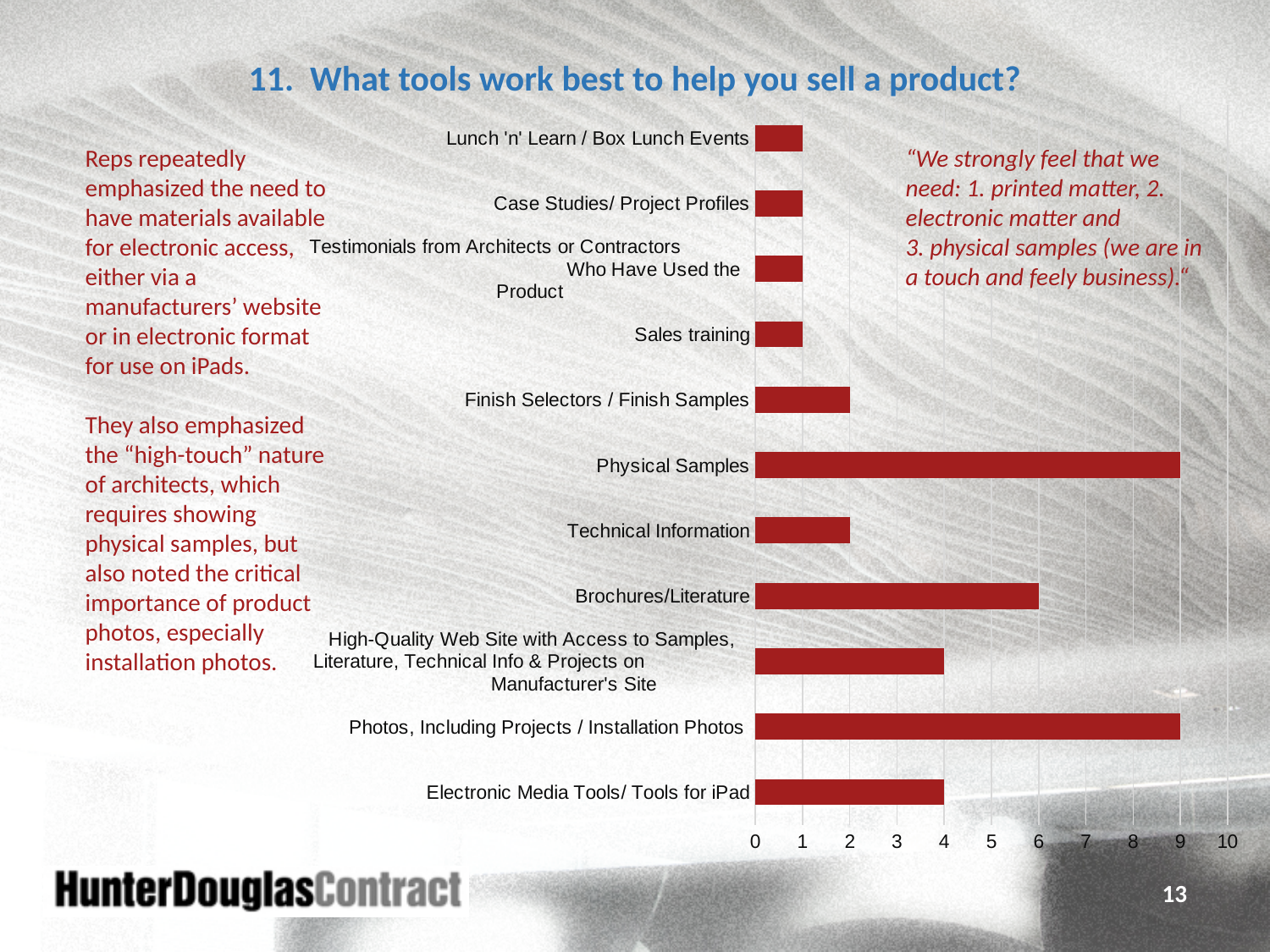
What type of chart is shown on the slide? bar chart How many categories (tools) are plotted in the chart? 11 Is the value for Photos, Including Projects / Installation Photos greater or less than 5? greater What is the value for Finish Selectors / Finish Samples? 2 Is the value for Case Studies/ Project Profiles greater or less than 3? less What is the value for Physical Samples? 9 What is the title of the slide containing the chart? 11. What tools work best to help you sell a product? What is the difference between the value for Physical Samples and the value for Brochures/Literature? 3 What is the value for Brochures/Literature? 6 What is the value for Sales training? 1 Which is larger, the value for Brochures/Literature or the value for Technical Information? Brochures/Literature What is the value for Electronic Media Tools/ Tools for iPad? 4